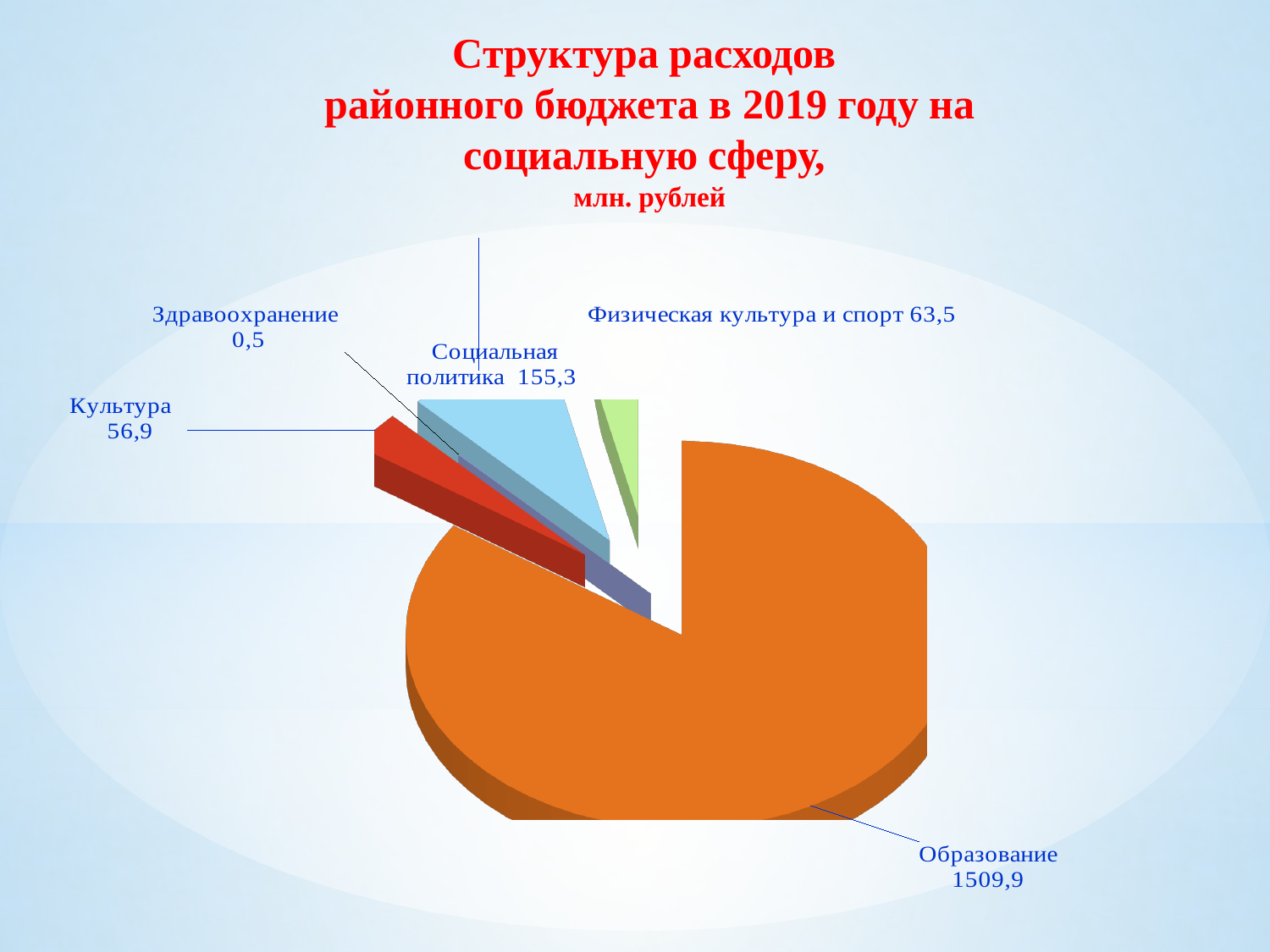
What is the value for Социальная политика? 155,3 Which category has the smallest share of the pie? Здравоохранение What is the value for Физическая культура и спорт? 63,5 In what units are the values on the chart given, according to the title? млн. рублей Which is larger, the value for Физическая культура и спорт or the value for Культура? Физическая культура и спорт Which category has the largest share of the pie? Образование What is the value for Культура? 56,9 What is the value for Образование? 1509,9 What is the value for Здравоохранение? 0,5 How many slices does the pie chart have? 5 What type of chart is shown on the slide? Pie chart What is the difference between the values for Образование and Социальная политика? 1354,6